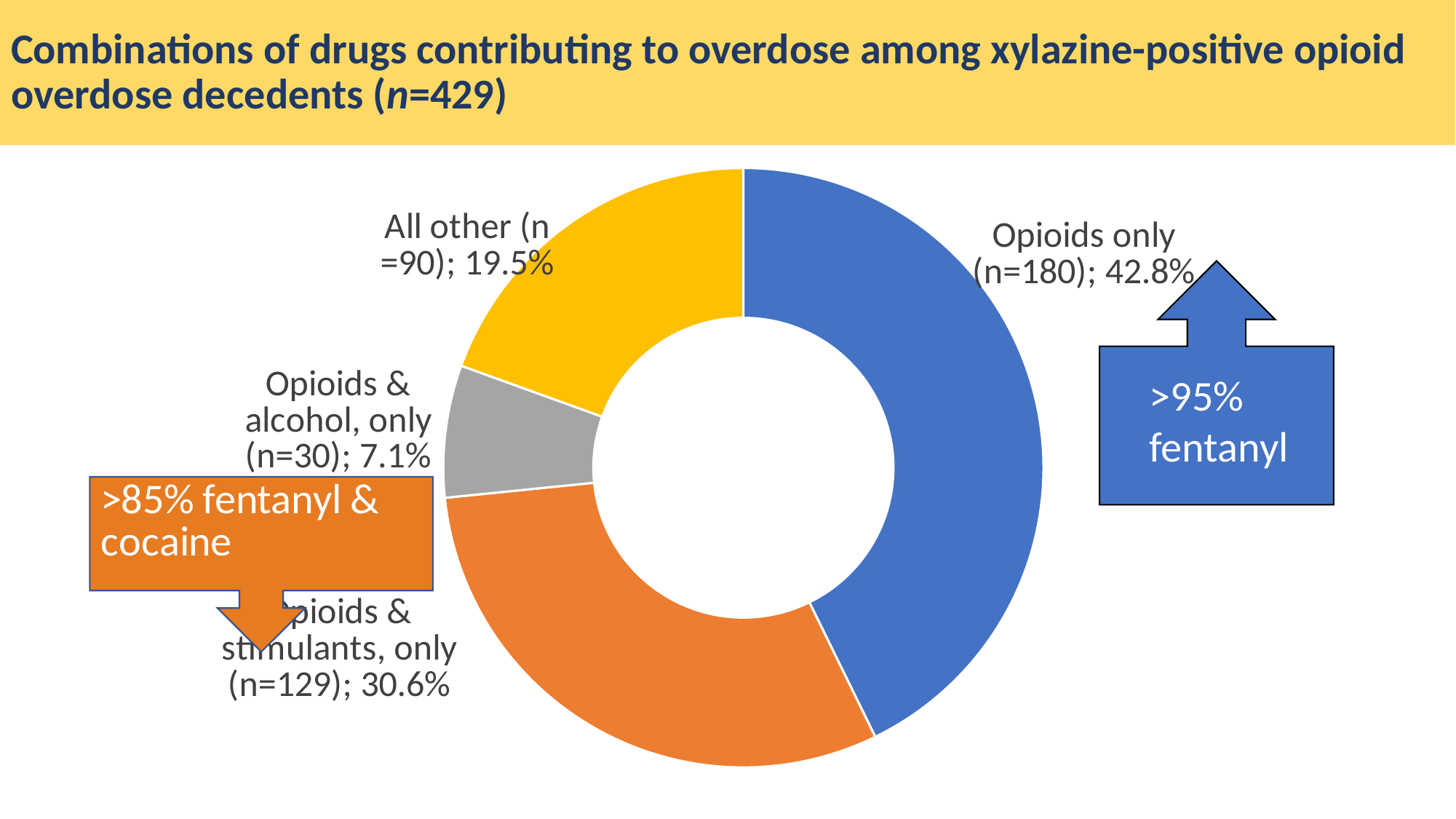
Which has a larger share: 'All other' or 'Opioids & alcohol, only'? All other What colour is the 'Opioids only' segment of the chart? Blue How many decedents are in the 'Opioids & stimulants, only' category? 129 How many categories are shown in the chart? 4 What is the difference in number of decedents between 'Opioids only' and 'Opioids & stimulants, only'? 51 What kind of chart is shown on the slide? Doughnut (pie) chart Which category has the largest share of the chart? Opioids only What is the total number of decedents (n) stated in the chart title? 429 How many decedents are in the 'Opioids & alcohol, only' category? 30 What percentage of xylazine-positive opioid overdose decedents had opioids only contributing to overdose? 42.8% Which category has the smallest share of the chart? Opioids & alcohol, only What percentage share does the 'All other' category have? 19.5%